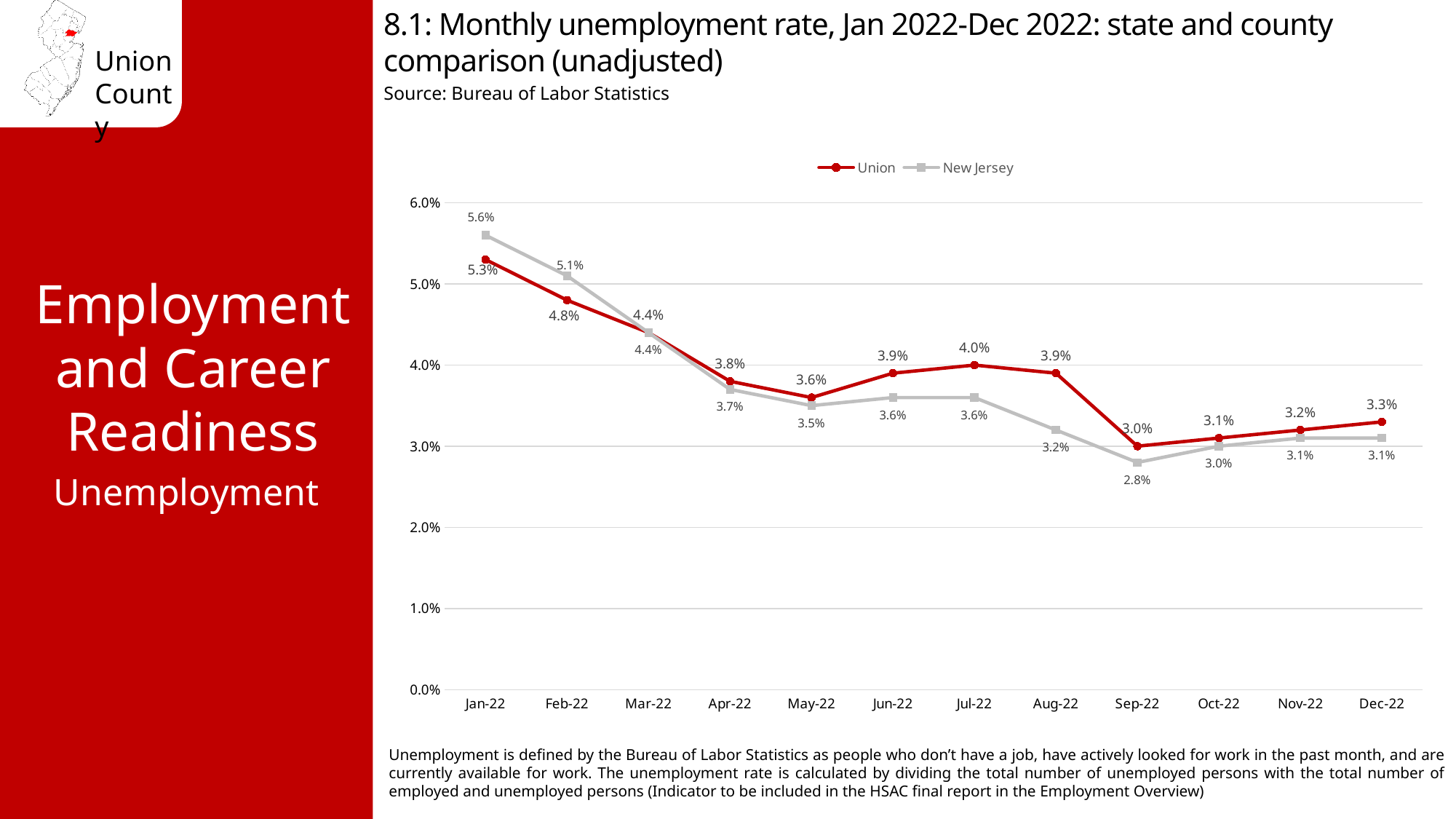
What was the unemployment rate for New Jersey in Sep-22? 2.8% In which month was the New Jersey unemployment rate highest? Jan-22 What kind of chart is shown on the slide? Line chart How many months are plotted on the x axis? 12 Which had the higher unemployment rate in Aug-22, Union or New Jersey? Union How many series does the legend list? 2 Did the Union unemployment rate rise or fall from Jan-22 to May-22? Fall Is the Union unemployment rate in Feb-22 greater or less than 4.0%? greater In which month was the Union unemployment rate lowest? Sep-22 What was the unemployment rate for Union in Jul-22? 4.0% What was the unemployment rate for Union in Jan-22? 5.3% What is the difference between the New Jersey and Union unemployment rates in Jan-22? 0.3%